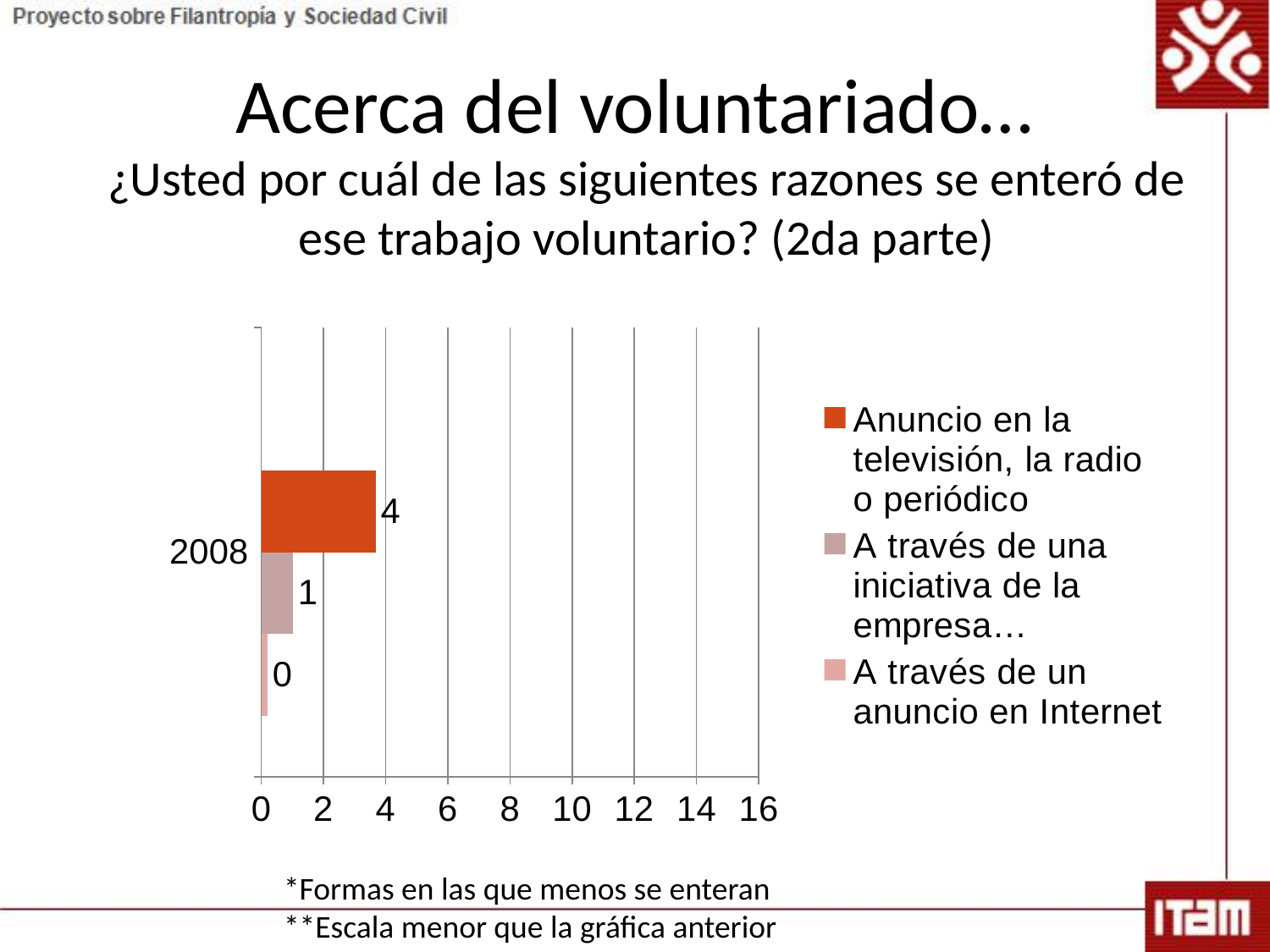
What value is shown for 'A través de un anuncio en Internet' in 2008? 0 What kind of chart is shown on the slide? bar chart Is the value for 'Anuncio en la televisión, la radio o periódico' greater or less than 8? less Which series has the lowest value in 2008? A través de un anuncio en Internet Which is larger: the value for 'A través de una iniciativa de la empresa…' or 'A través de un anuncio en Internet'? A través de una iniciativa de la empresa… What value is shown for 'Anuncio en la televisión, la radio o periódico' in 2008? 4 What is the difference between the value for 'Anuncio en la televisión, la radio o periódico' and 'A través de una iniciativa de la empresa…'? 3 Which year is labelled on the vertical axis of the chart? 2008 What value is shown for 'A través de una iniciativa de la empresa…' in 2008? 1 How many series does the legend list? 3 Which series has the highest value in 2008? Anuncio en la televisión, la radio o periódico What is the maximum value shown on the horizontal axis? 16